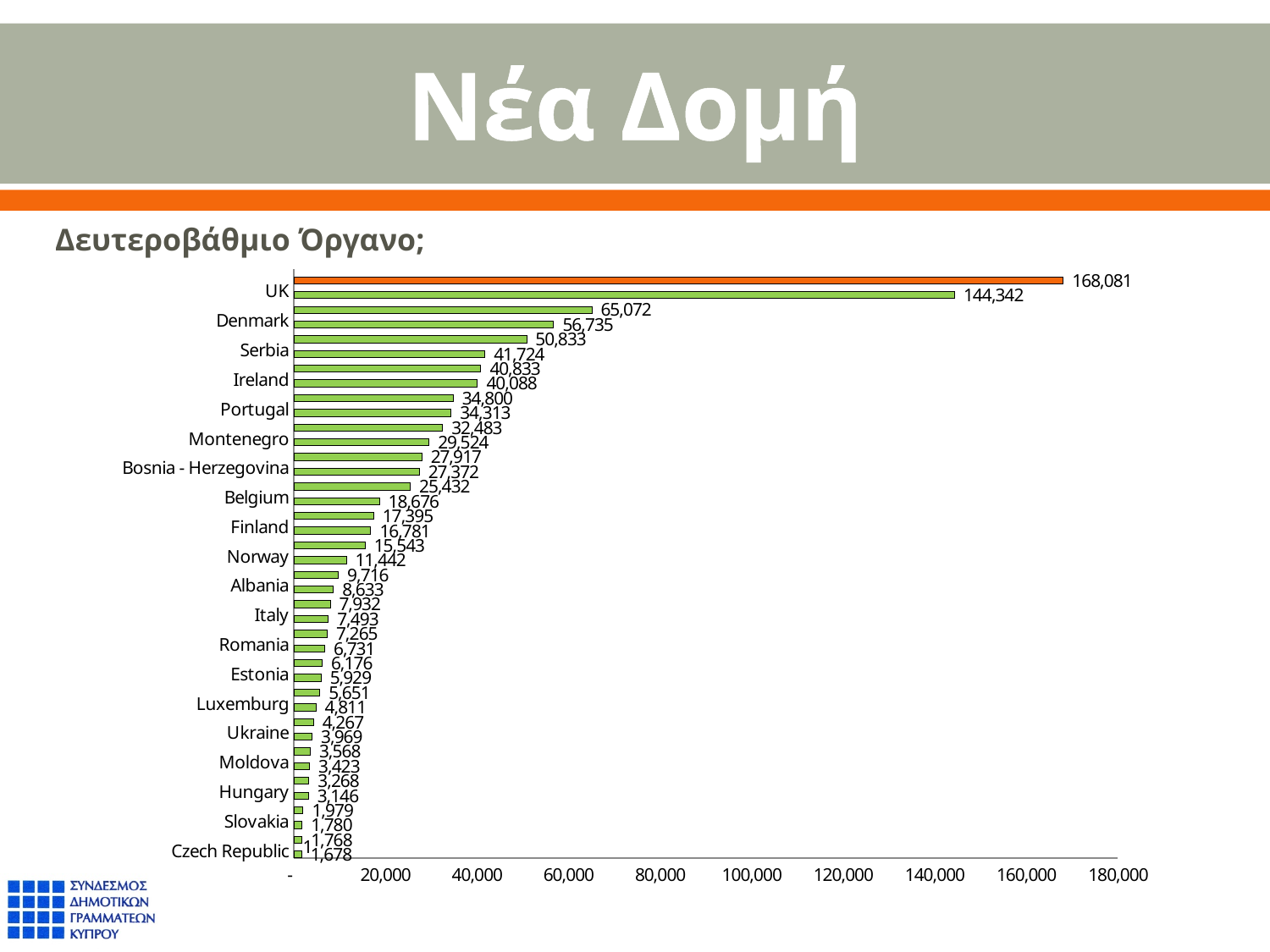
Which has a larger value, Serbia or Ireland? Serbia Which labelled country has the lowest value? Czech Republic What kind of chart is shown on the slide? Bar chart Is the value for the UK greater or less than 140,000? greater What is the value for the UK? 144,342 What is the value for Denmark? 56,735 Do the values rise or fall going from the top of the chart to the bottom? Fall What colour is the topmost bar, which differs from the others? Orange What is the value for Czech Republic? 1,678 What is the largest value shown on the chart? 168,081 What is the difference between the values for the UK and Denmark? 87,607 What is the value for Belgium? 18,676